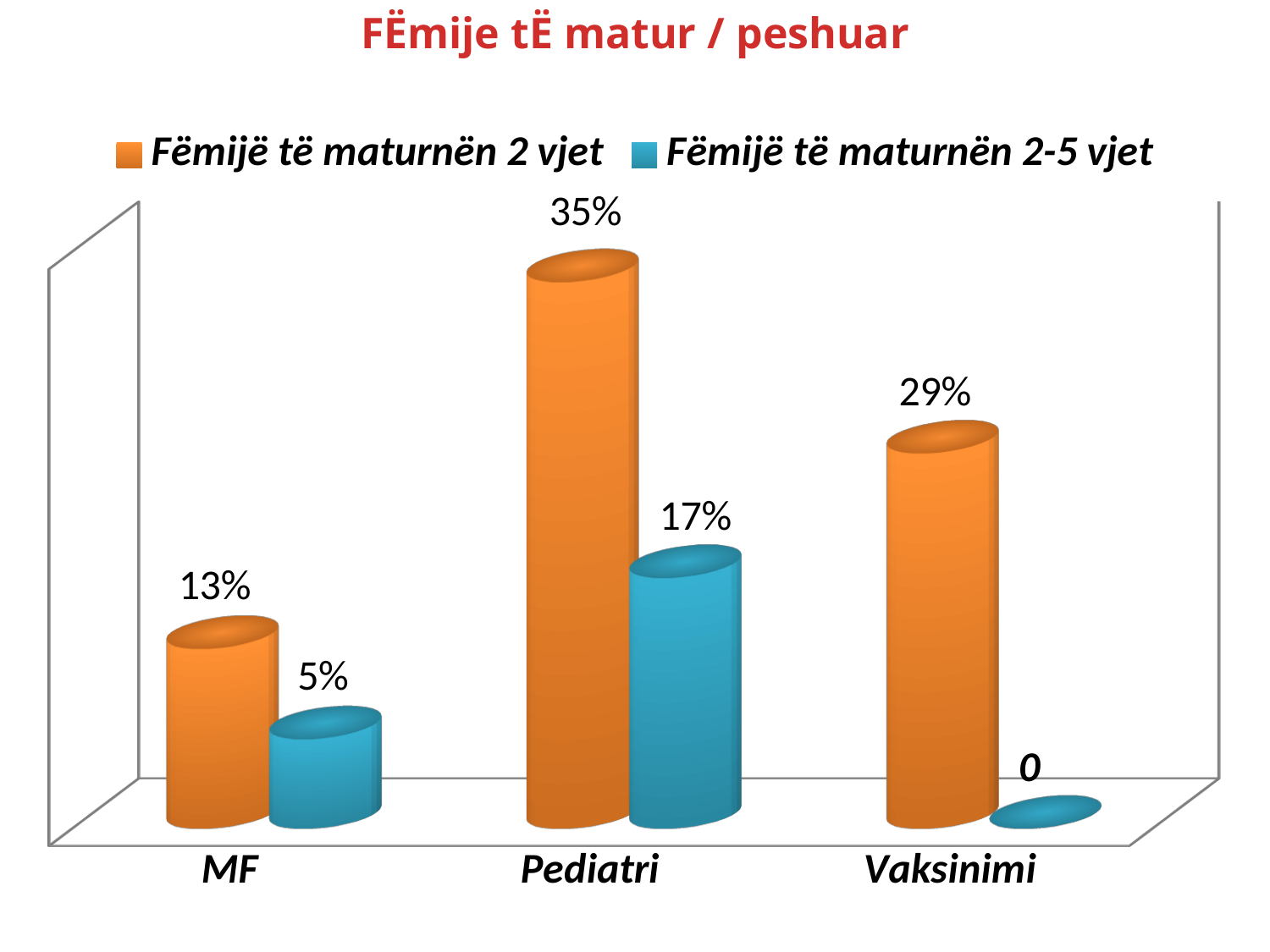
Which category has the lowest value in the 'Fëmijë të maturnën 2-5 vjet' series? Vaksinimi How many series does the legend list? 2 Which is larger: the 'Fëmijë të maturnën 2 vjet' value for MF or for Vaksinimi? Vaksinimi What is the value for MF in the 'Fëmijë të maturnën 2 vjet' series? 13% What is the value for Vaksinimi in the 'Fëmijë të maturnën 2 vjet' series? 29% What is the value for Pediatri in the 'Fëmijë të maturnën 2-5 vjet' series? 17% How many categories are shown on the x axis? 3 What is the difference between the 'Fëmijë të maturnën 2 vjet' and 'Fëmijë të maturnën 2-5 vjet' values for Pediatri? 18% What is the value for Vaksinimi in the 'Fëmijë të maturnën 2-5 vjet' series? 0 What is the title of the chart? FËmije tË matur / peshuar Which category has the highest value in the 'Fëmijë të maturnën 2 vjet' series? Pediatri What kind of chart is shown on the slide? Bar chart